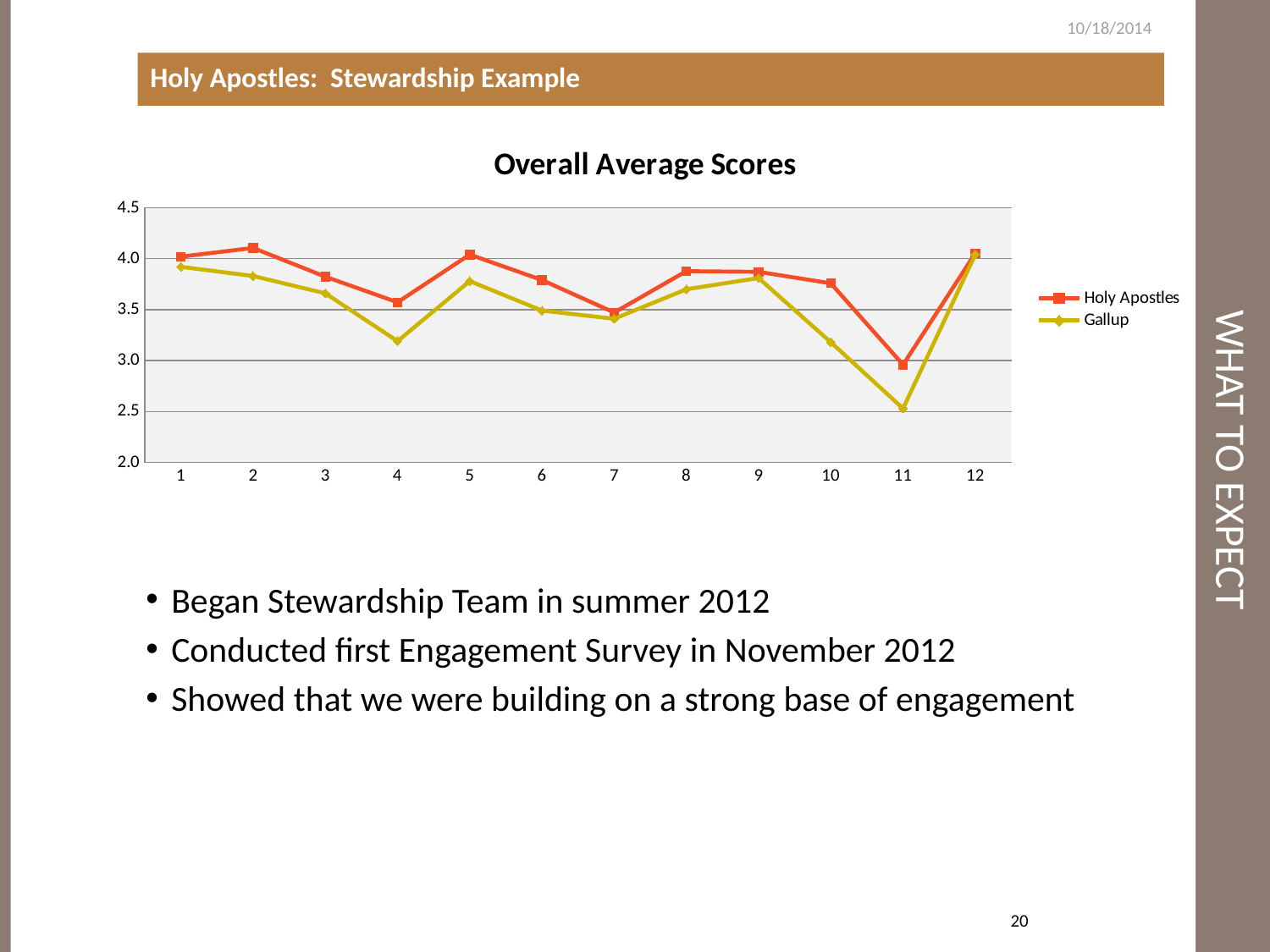
What kind of chart is shown on the slide? Line chart At which x-axis point does the Holy Apostles series reach its lowest value? 11 At which x-axis point does the Gallup series reach its lowest value? 11 How many points are plotted along the x axis for each series? 12 What is the title of the chart? Overall Average Scores How many series does the chart's legend list? 2 Is the Holy Apostles value at point 2 greater or less than 4.0? greater At point 4, which series has the larger value, Holy Apostles or Gallup? Holy Apostles At which x-axis point does the Gallup series reach its highest value? 12 Is the Gallup value at point 4 greater or less than 3.5? less Is the Gallup value at point 11 greater or less than 3.0? less Does the Holy Apostles series rise or fall from point 9 to point 11? Fall